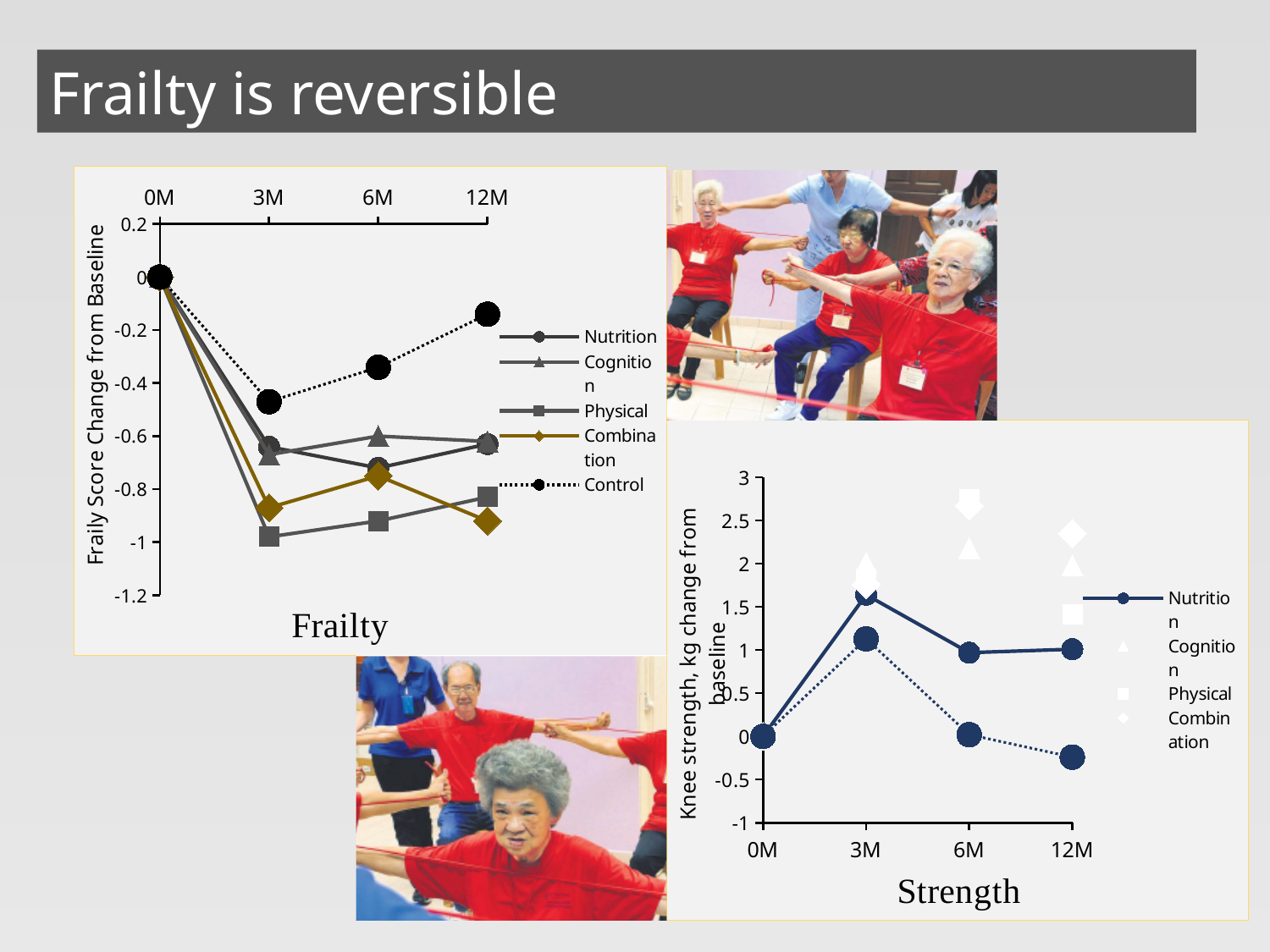
In the Frailty chart, is the value for Physical at 3M greater or less than -0.8? less In the Frailty chart, is the value for Control at 3M greater or less than -0.6? greater In the Strength chart, is the value for Nutrition at 3M greater or less than 1? greater In the Frailty chart, how many time points are shown on the x axis? 4 In the Frailty chart, what is the value for all series at 0M? 0 In the Strength chart, which series has the highest value at 6M? Physical In the Frailty chart, which series has the highest value at 12M? Control In the Frailty chart, what kind of chart is used to show the data? line chart In the Frailty chart, which series has the lowest value at 3M? Physical In the Strength chart, what is the y-axis title? Knee strength, kg change from baseline In the Frailty chart, how many series does the legend list? 5 In the Strength chart, how many series does the legend list? 4